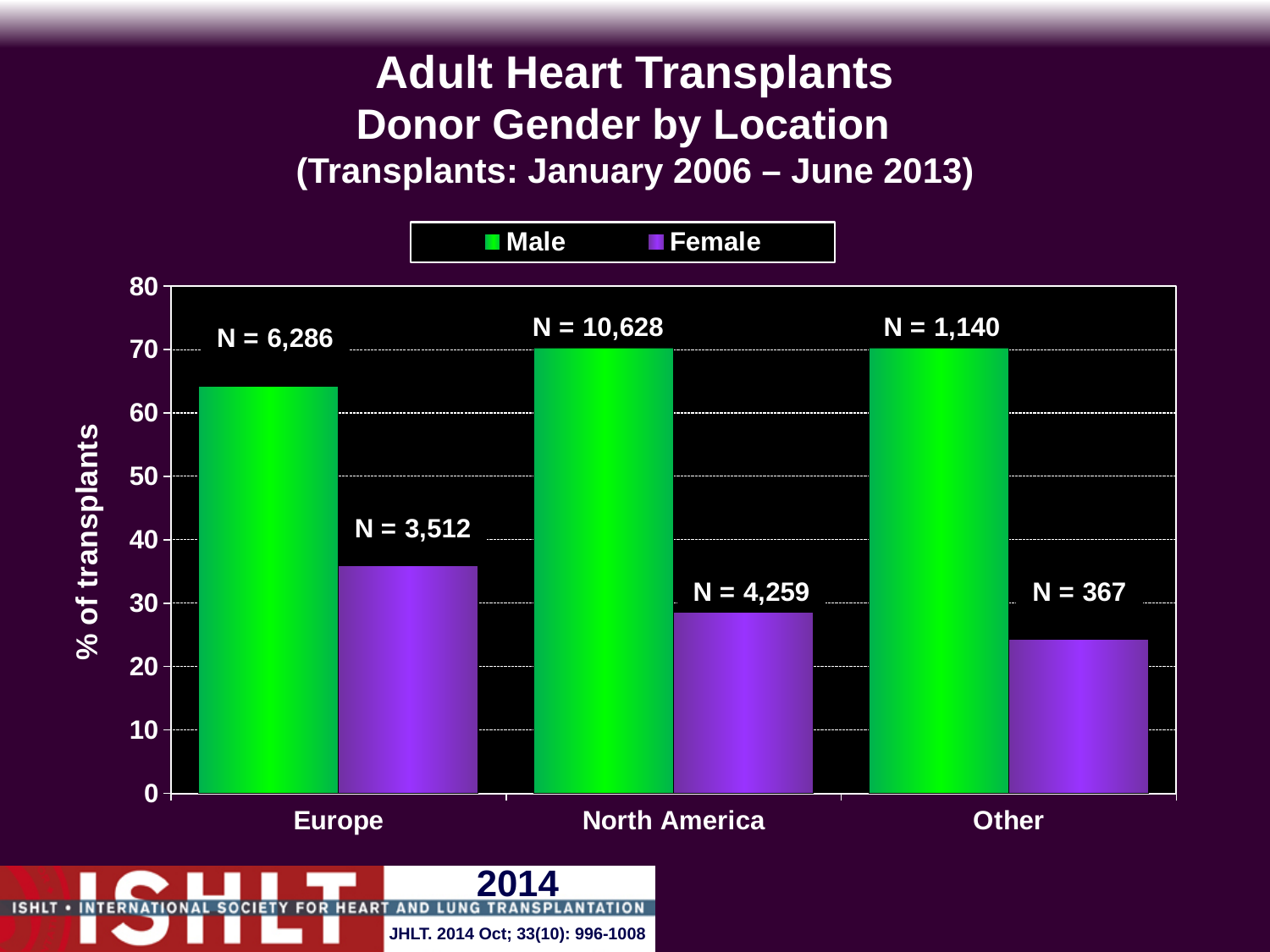
What is the N value printed above the Female bar for Other? N = 367 What kind of chart is shown on the slide? bar chart How many location categories are shown on the x axis? 3 What is the N value printed above the Female bar for North America? N = 4,259 How many series does the legend list? 2 What is the N value printed above the Male bar for North America? N = 10,628 What is the N value printed above the Male bar for Europe? N = 6,286 Is the Female value for Other greater or less than 30? less Which is larger, the Female value for Europe or the Female value for North America? Europe Is the Male value for Europe greater or less than 60? greater What is the difference between the Male N and the Female N for Europe? 2,774